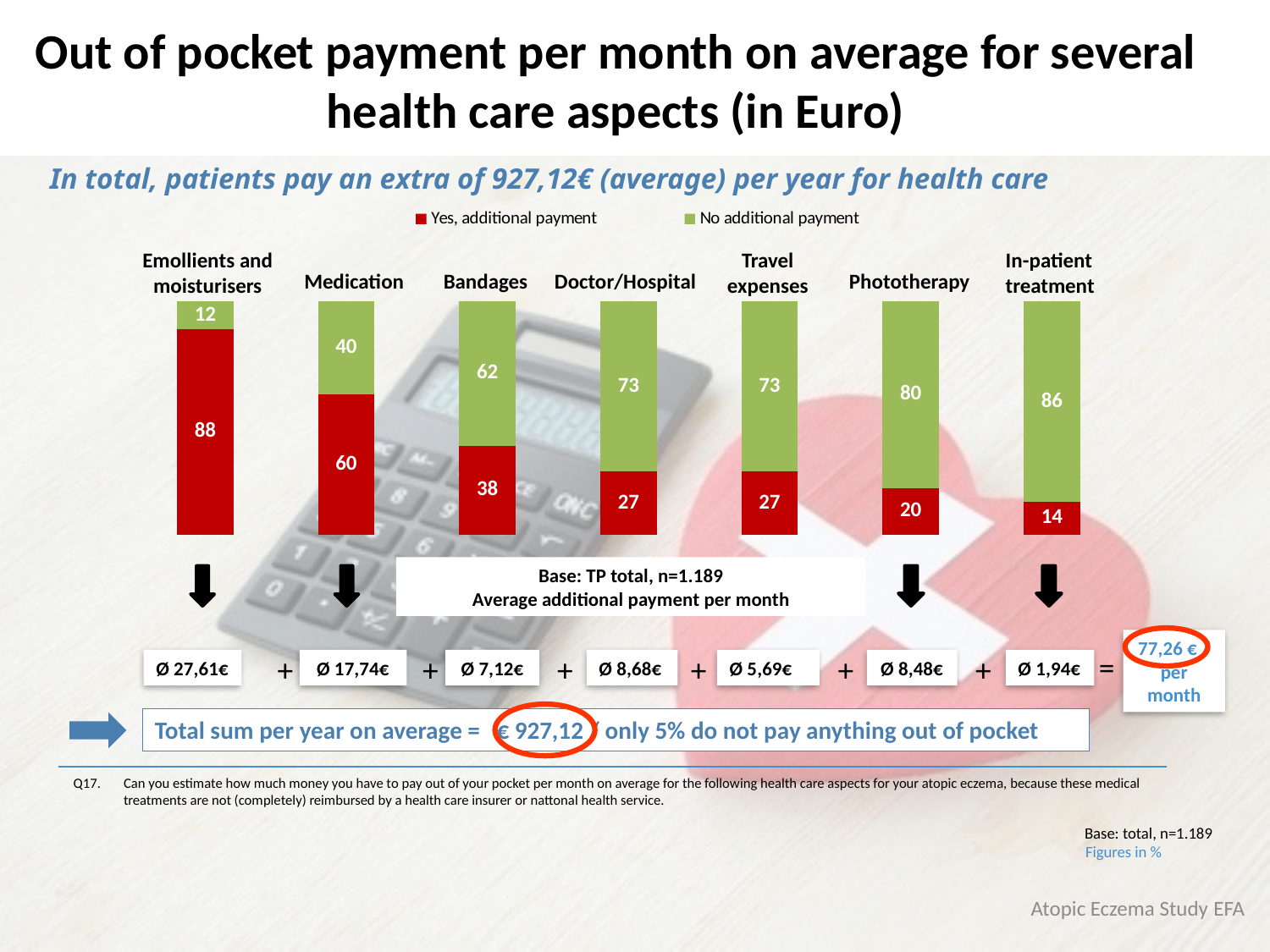
What kind of chart is shown on the slide? Stacked bar chart Which is larger: the 'No additional payment' value for Bandages or for Doctor/Hospital? Doctor/Hospital Which category has the lowest 'Yes, additional payment' value? In-patient treatment What percentage of patients report additional payment for emollients and moisturisers? 88 How many categories are shown in the chart? 7 What is the value for 'No additional payment' for Medication? 40 How many series does the legend list? 2 What is the total of the stacked bar for Travel expenses? 100 What is the difference between the 'Yes, additional payment' values for Medication and Phototherapy? 40 Which colour represents 'Yes, additional payment' in the chart? Red What is the 'Yes, additional payment' value for Bandages? 38 Which category has the highest 'Yes, additional payment' value? Emollients and moisturisers